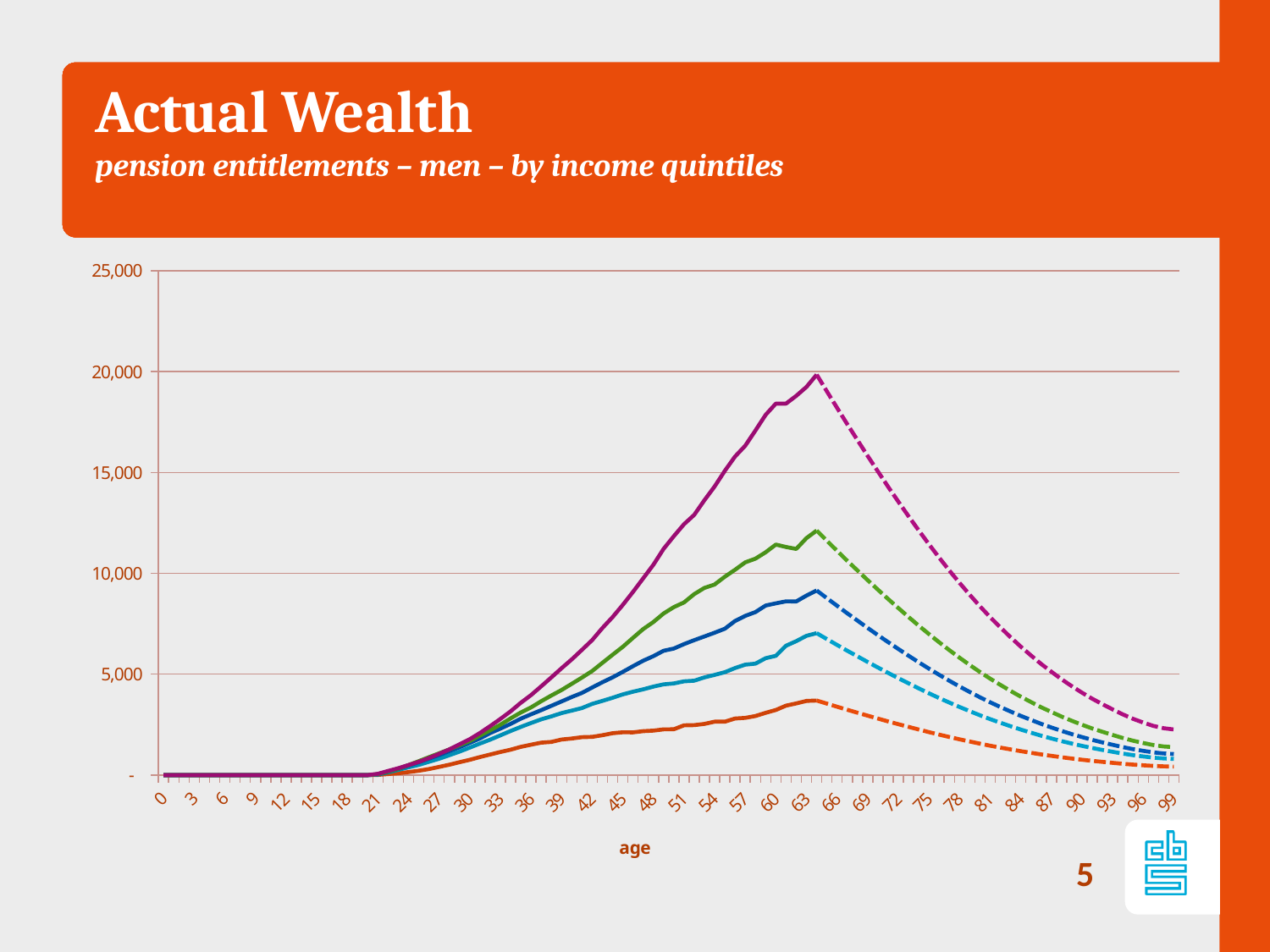
Which line reaches the highest value on the chart? the purple line Is the peak value of the orange line greater or less than 5,000? less Is the peak value of the green line greater or less than 10,000? greater Is the peak value of the purple line greater or less than 15,000? greater Do the lines rise or fall between age 66 and age 99? fall What kind of chart is shown on the slide? line chart Do the lines rise or fall between age 30 and age 60? rise What is the title of the chart on the slide? Actual Wealth How many lines are plotted on the chart? 5 What is the label of the x axis? age Which line stays lowest across the ages? the orange line